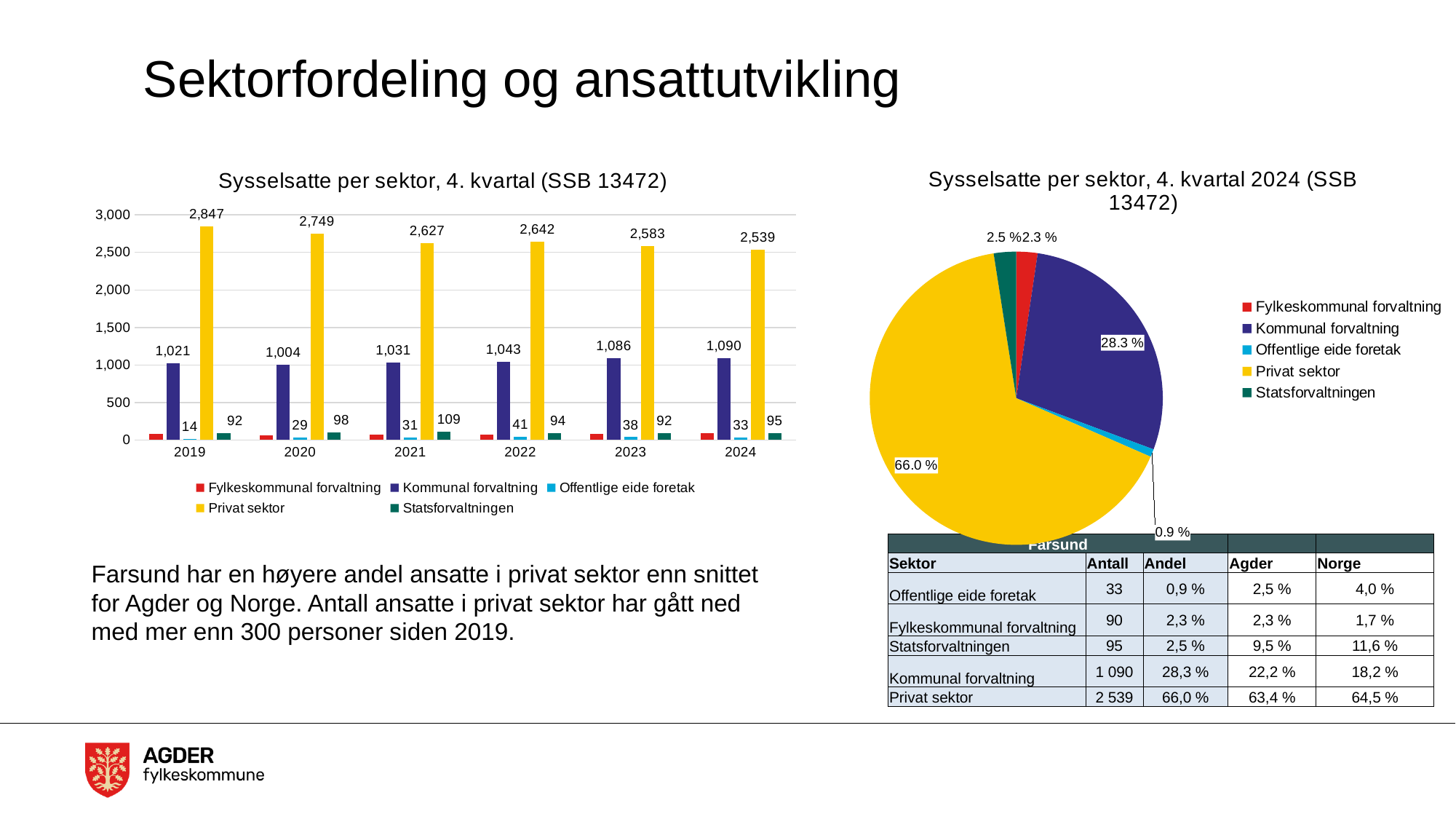
What kind of chart is the chart on the left of the slide? bar chart In the bar chart 'Sysselsatte per sektor, 4. kvartal (SSB 13472)', is the value for Fylkeskommunal forvaltning in 2024 greater or less than 500? less In the bar chart 'Sysselsatte per sektor, 4. kvartal (SSB 13472)', in which year is Offentlige eide foretak lowest? 2019 In the bar chart 'Sysselsatte per sektor, 4. kvartal (SSB 13472)', what is the value for Privat sektor in 2019? 2,847 In the bar chart 'Sysselsatte per sektor, 4. kvartal (SSB 13472)', is Statsforvaltningen larger in 2021 or in 2022? 2021 In the bar chart 'Sysselsatte per sektor, 4. kvartal (SSB 13472)', how many series does the legend list? 5 In the bar chart 'Sysselsatte per sektor, 4. kvartal (SSB 13472)', what is the difference between Privat sektor in 2019 and in 2024? 308 In the pie chart 'Sysselsatte per sektor, 4. kvartal 2024 (SSB 13472)', which sector has the largest slice? Privat sektor In the bar chart 'Sysselsatte per sektor, 4. kvartal (SSB 13472)', in which year is Privat sektor highest? 2019 In the pie chart 'Sysselsatte per sektor, 4. kvartal 2024 (SSB 13472)', what share does Privat sektor have? 66.0 % In the bar chart 'Sysselsatte per sektor, 4. kvartal (SSB 13472)', what is the value for Kommunal forvaltning in 2024? 1,090 In the bar chart 'Sysselsatte per sektor, 4. kvartal (SSB 13472)', how many years are shown on the x axis? 6